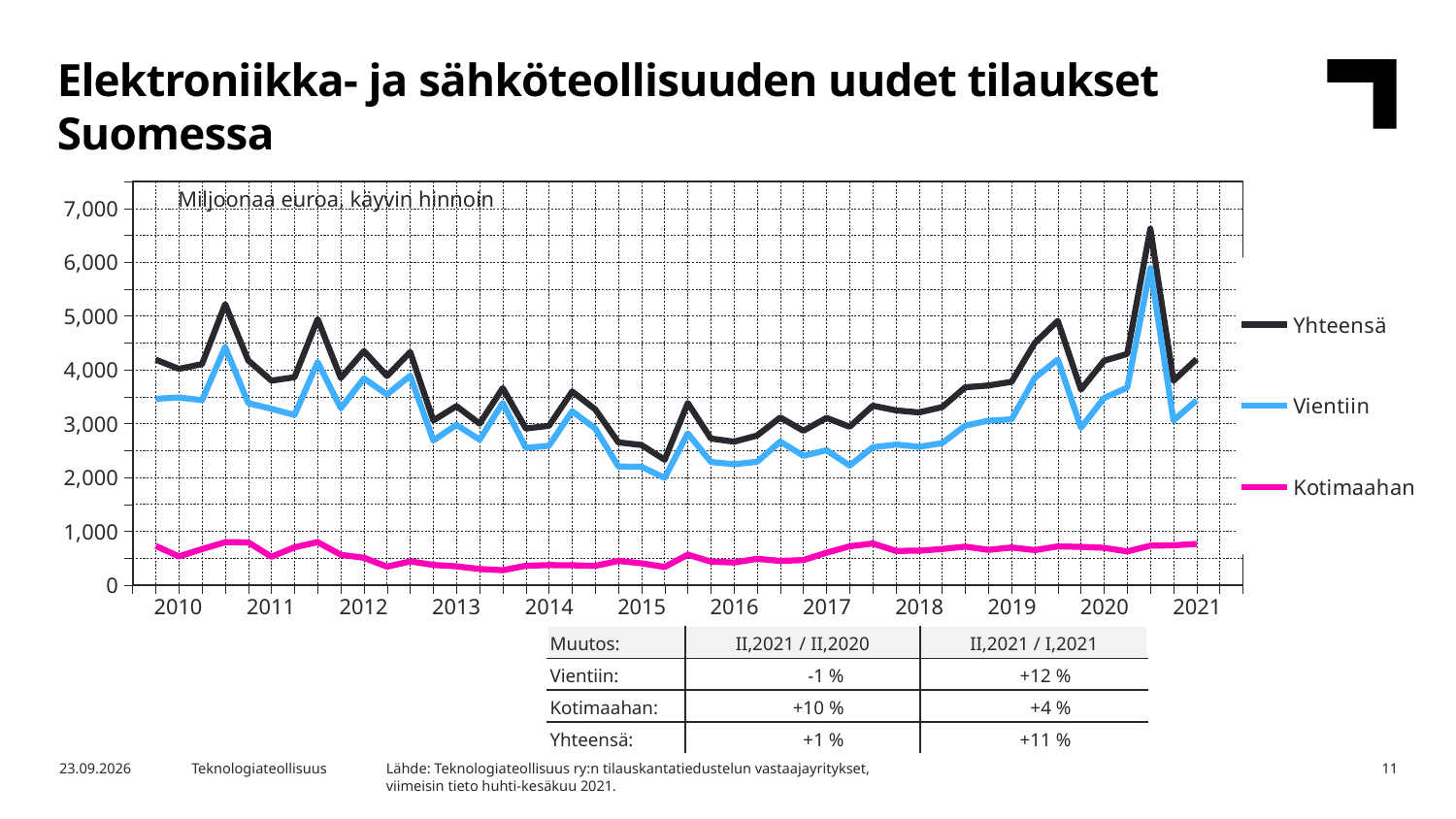
Is the value for Vientiin at the start of 2015 greater or less than 3,000? less Which is larger at the start of 2021, the value for Vientiin or the value for Kotimaahan? Vientiin What are the three series named in the chart legend? Yhteensä, Vientiin, Kotimaahan Is the peak value of the Yhteensä line greater or less than 6,000? greater Is the value for Kotimaahan at the start of 2010 greater or less than 1,000? less Does the Yhteensä line generally rise or fall between 2015 and 2019? rise What unit label is printed inside the chart area? Miljoonaa euroa, käyvin hinnoin What kind of chart is shown on the slide? Line chart How many series does the chart legend list? 3 Which series has the lowest values throughout the chart? Kotimaahan How many year labels are shown on the x axis? 12 Which series has the highest values throughout the chart? Yhteensä